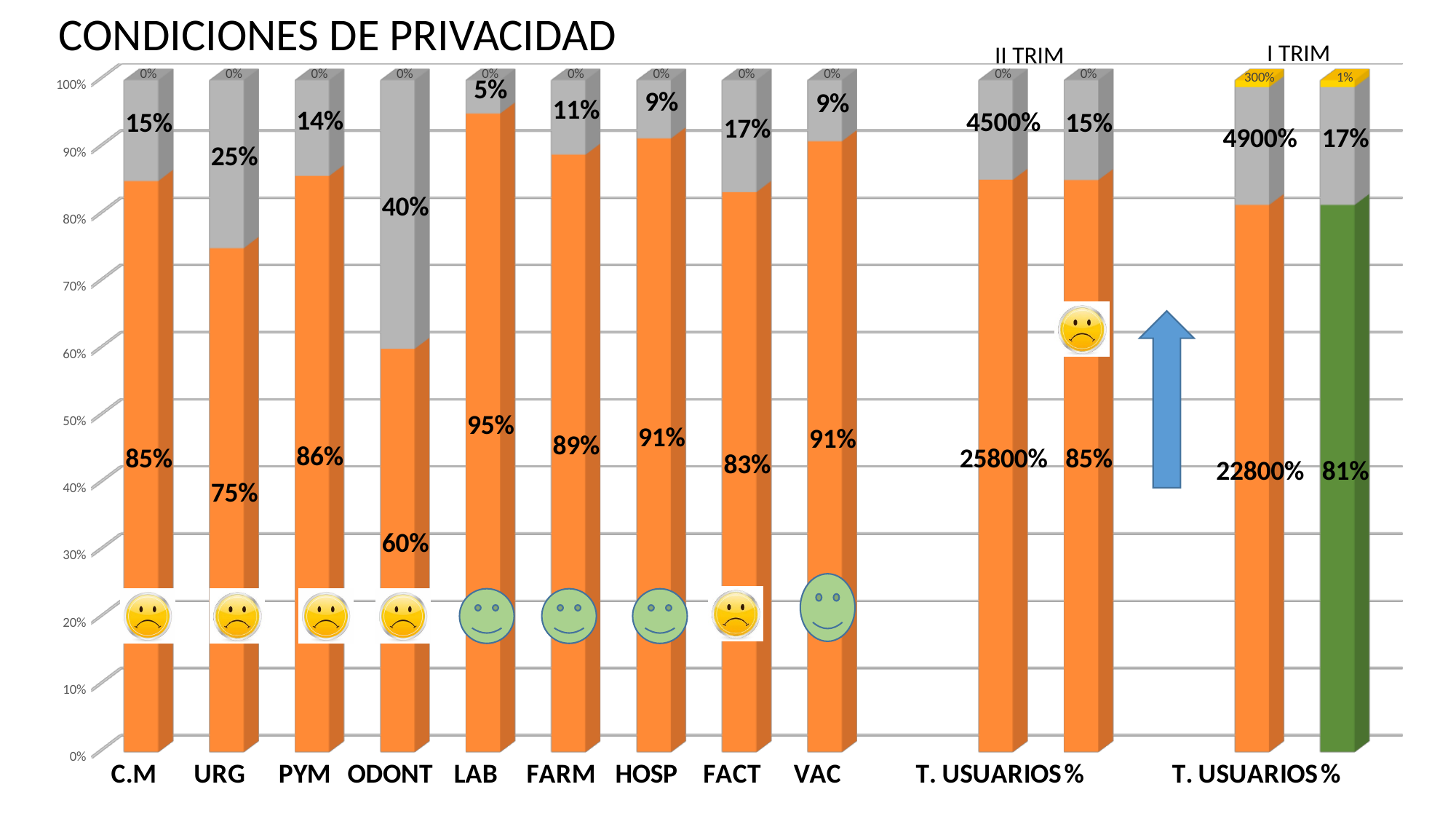
Which of the first nine categories (C.M through VAC) has the lowest orange segment value? ODONT Is the orange segment value for ODONT greater or less than 70%? less What is the value of the orange segment for URG? 75% What is the value of the gray segment for ODONT? 40% What is the title of the chart? CONDICIONES DE PRIVACIDAD Which of the first nine categories (C.M through VAC) has the highest orange segment value? LAB What is the value of the gray segment for FACT? 17% What is the value of the green segment in the I TRIM bar on the far right? 81% What kind of chart is shown on the slide? Stacked bar chart Which has a larger orange segment value, HOSP or FARM? HOSP What is the difference between the orange segment values for C.M and URG? 10% What is the value of the orange segment for LAB? 95%